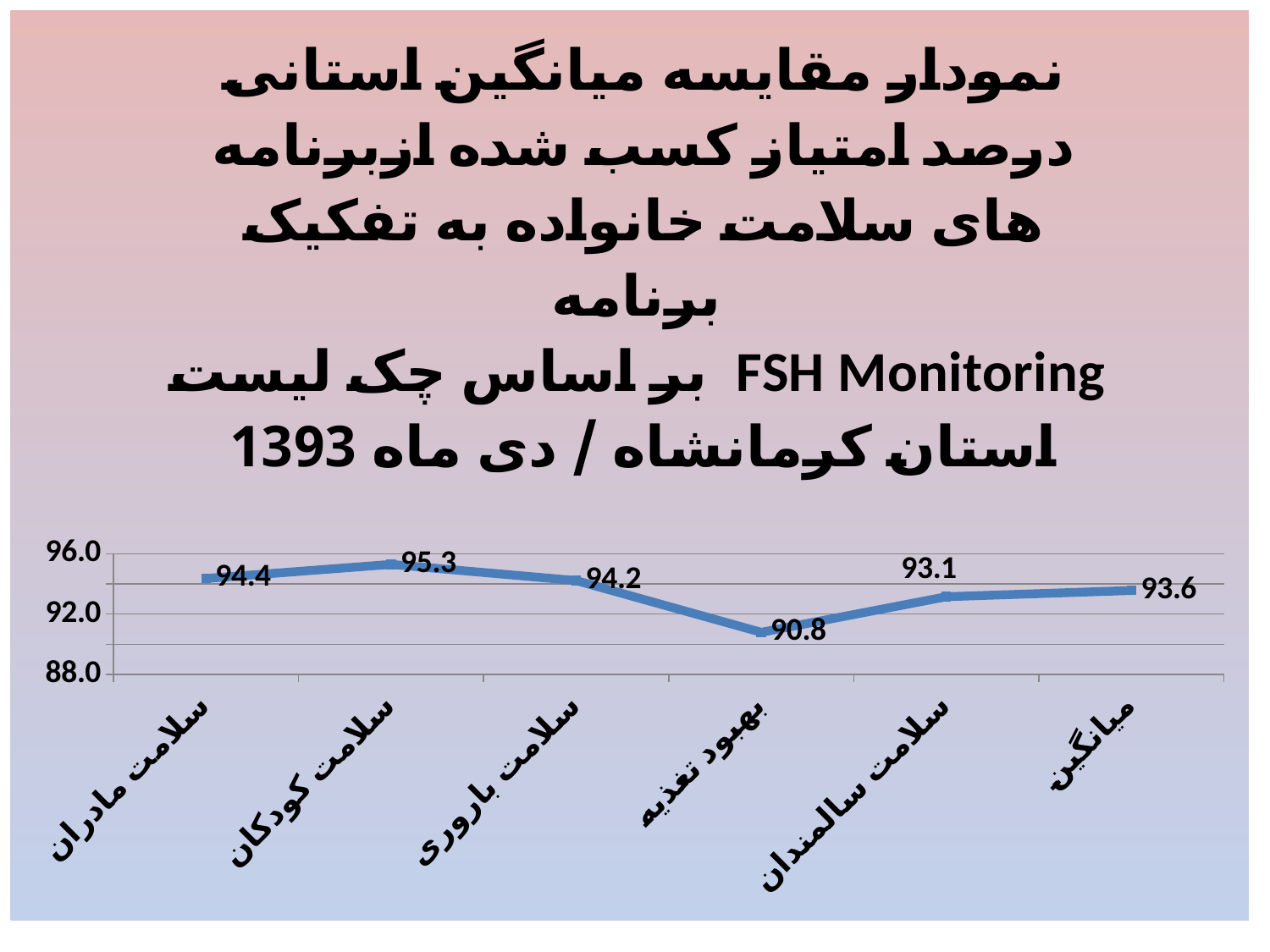
What type of chart is shown on the slide? line chart Does the line rise or fall between سلامت باروری and بهبود تغذیه? fall What is the difference between the values for سلامت کودکان and بهبود تغذیه? 4.5 How many categories are plotted on the x axis? 6 What is the value for میانگین? 93.6 Which category has the highest value? سلامت کودکان Which category has the lowest value? بهبود تغذیه What is the value for سلامت مادران? 94.4 What is the value for بهبود تغذیه? 90.8 Which is larger, the value for سلامت باروری or the value for سلامت سالمندان? سلامت باروری What is the value for سلامت کودکان? 95.3 Is the value for بهبود تغذیه greater or less than 92.0? less